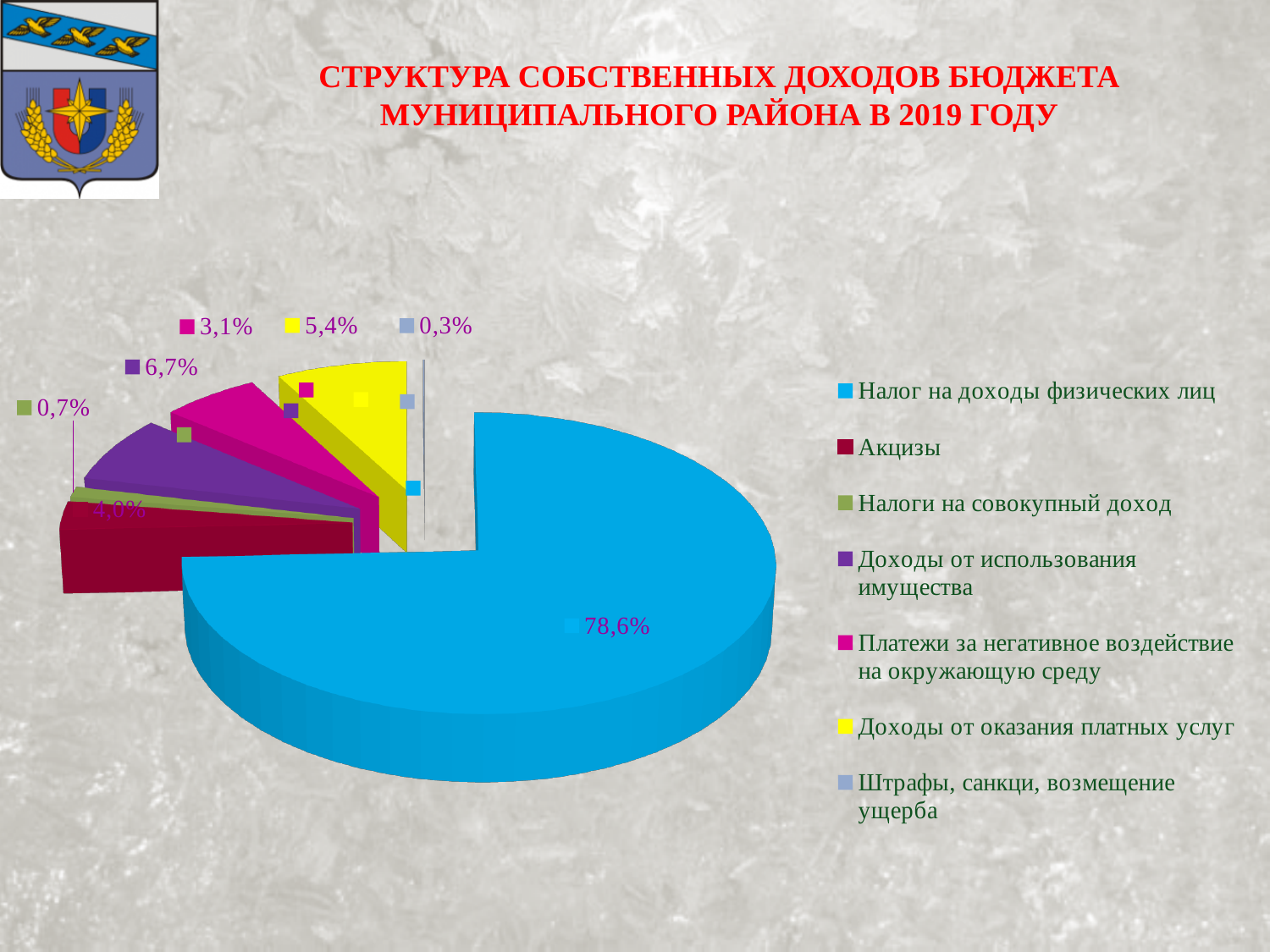
Which category has the largest share of the pie? Налог на доходы физических лиц What kind of chart is shown on the slide? Pie chart What share of the pie does "Налог на доходы физических лиц" have? 78,6% What is the value shown for "Штрафы, санкци, возмещение ущерба"? 0,3% What is the value shown for "Платежи за негативное воздействие на окружающую среду"? 3,1% Which category has the smallest share of the pie? Штрафы, санкци, возмещение ущерба What is the title of the chart on the slide? СТРУКТУРА СОБСТВЕННЫХ ДОХОДОВ БЮДЖЕТА МУНИЦИПАЛЬНОГО РАЙОНА В 2019 ГОДУ What is the value shown for "Доходы от оказания платных услуг"? 5,4% What is the value shown for "Доходы от использования имущества"? 6,7% Which is larger: the share for "Доходы от использования имущества" or for "Доходы от оказания платных услуг"? Доходы от использования имущества How many categories does the legend list? 7 What is the value shown for "Налоги на совокупный доход"? 0,7%